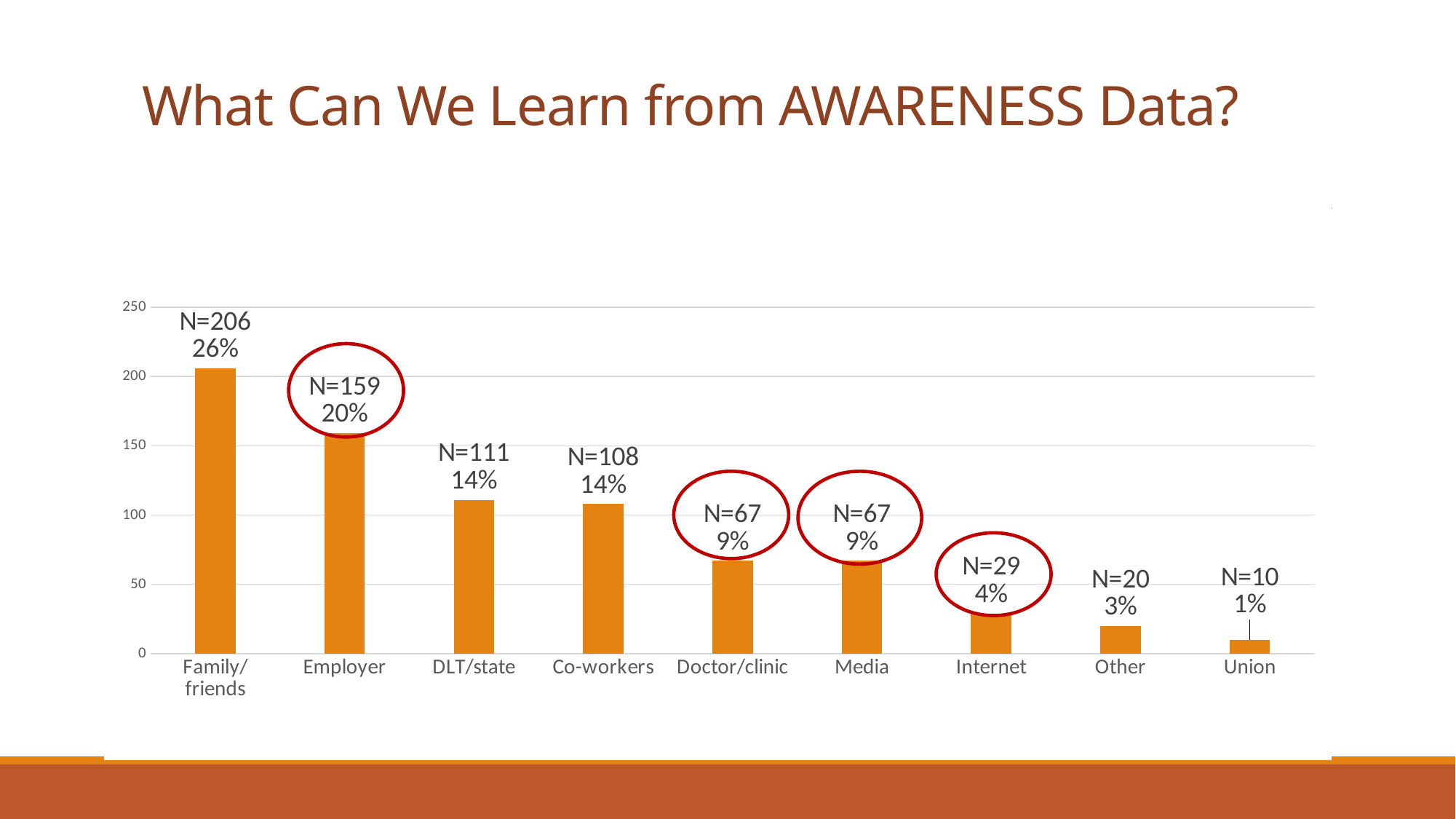
Which category has the lowest value? Union How many categories are shown on the x axis? 9 What kind of chart is shown on the slide? bar chart What is the N value for Family/friends? N=206 What is the N value for Internet? N=29 How many data labels are circled in red on the chart? 4 Which is larger, the value for DLT/state or the value for Co-workers? DLT/state Which category has the highest value? Family/friends What percentage is shown for Employer? 20% Do the values rise or fall from left to right along the x axis? fall What is the difference in N between Family/friends and Employer? 47 Is the value for Employer greater or less than 150? greater